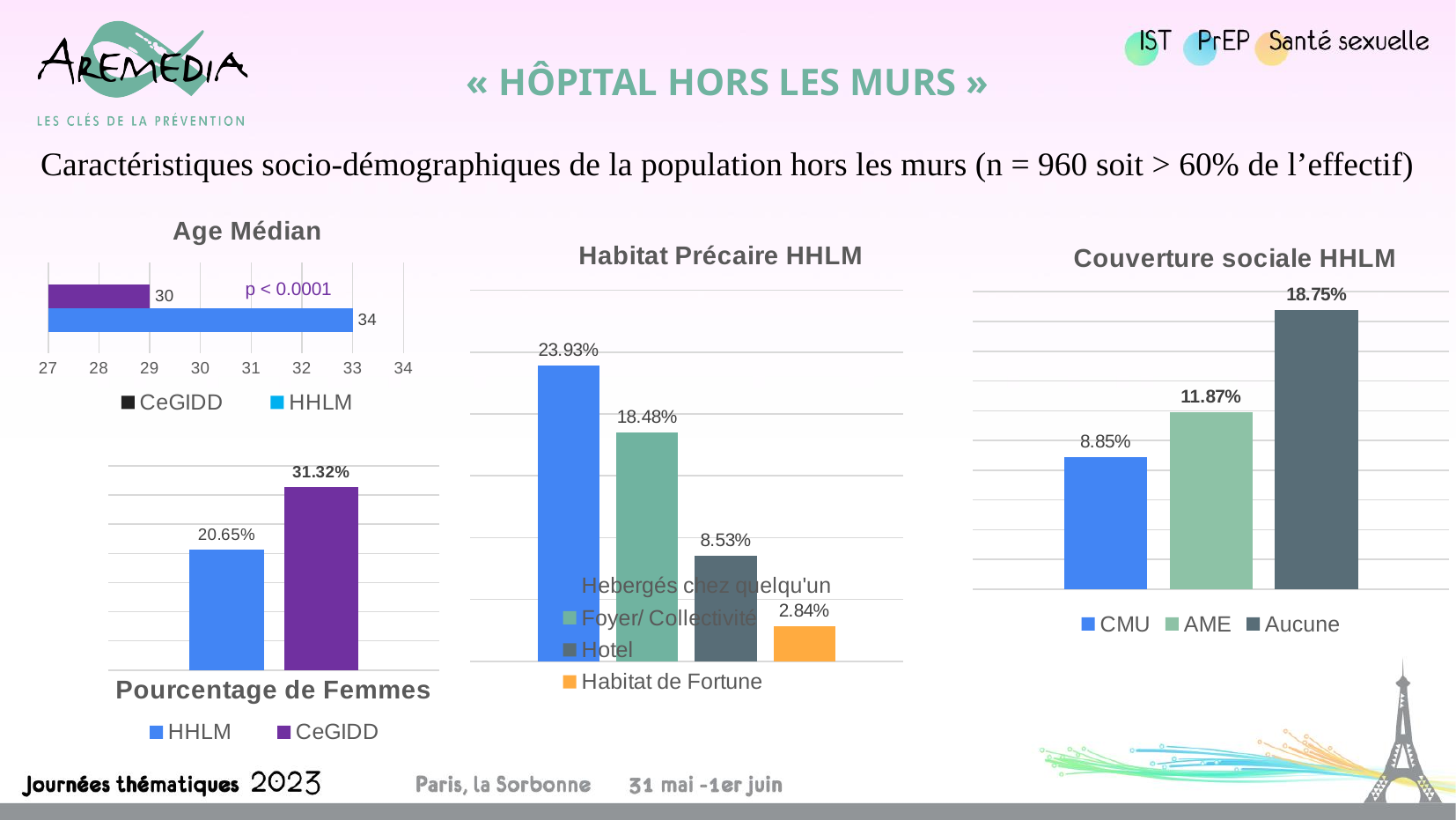
In the 'Couverture sociale HHLM' chart, what is the difference between Aucune and CMU? 9.90% In the 'Pourcentage de Femmes' chart, which group has the higher percentage, HHLM or CeGIDD? CeGIDD In the 'Age Médian' chart, what is the difference between the two bar values? 4 In the 'Couverture sociale HHLM' chart, which category has the highest value? Aucune In the 'Couverture sociale HHLM' chart, what is the value for AME? 11.87% In the 'Age Médian' chart, what p-value is printed on the chart? p < 0.0001 In the 'Pourcentage de Femmes' chart, what is the value for HHLM? 20.65% In the 'Habitat Précaire HHLM' chart, what is the value for Hotel? 8.53% In the 'Habitat Précaire HHLM' chart, how many categories are plotted? 4 In the 'Pourcentage de Femmes' chart, what is the value for CeGIDD? 31.32% In the 'Habitat Précaire HHLM' chart, which category has the lowest value? Habitat de Fortune In the 'Age Médian' chart, what is the value shown on the longer bar? 34